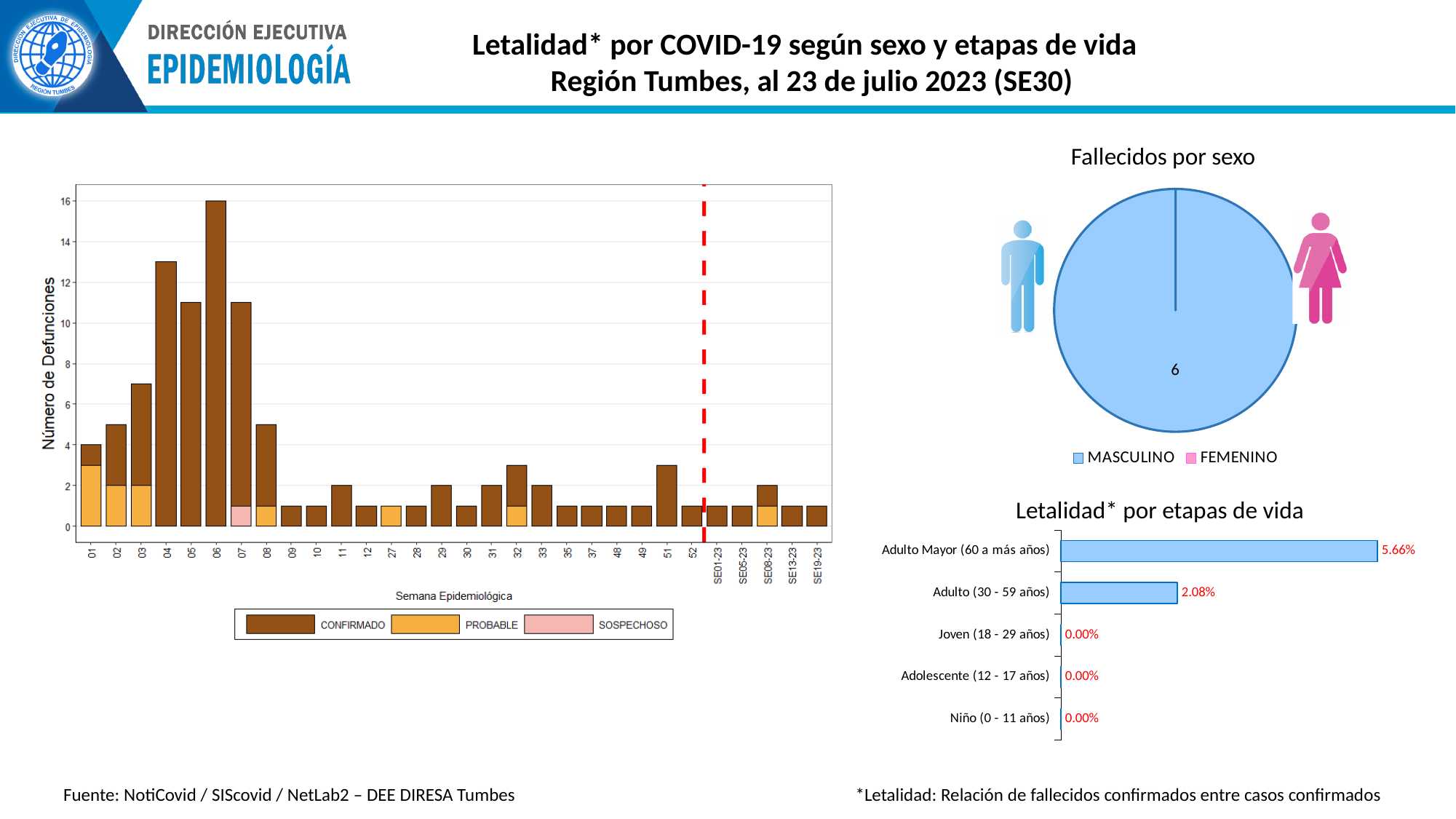
In the 'Fallecidos por sexo' pie chart, what value is shown for MASCULINO? 6 In the 'Letalidad* por etapas de vida' chart, what is the difference between the values for Adulto Mayor (60 a más años) and Adulto (30 - 59 años)? 3.58% In the bar chart of Número de Defunciones by Semana Epidemiológica, is the value for week 04 greater or less than 12? greater In the 'Letalidad* por etapas de vida' chart, what is the value for Adulto (30 - 59 años)? 2.08% In the 'Letalidad* por etapas de vida' chart, what is the value for Adulto Mayor (60 a más años)? 5.66% In the 'Letalidad* por etapas de vida' chart, how many age groups are shown? 5 How many series does the legend of the Número de Defunciones bar chart list? 3 What kind of chart is 'Letalidad* por etapas de vida'? Bar chart In the 'Letalidad* por etapas de vida' chart, which age group has the highest value? Adulto Mayor (60 a más años) In the bar chart of Número de Defunciones by Semana Epidemiológica, is the value for week 08 greater or less than 8? less In the bar chart of Número de Defunciones by Semana Epidemiológica, which week has the highest number of deaths? 06 How many entries does the legend of the 'Fallecidos por sexo' pie chart list? 2